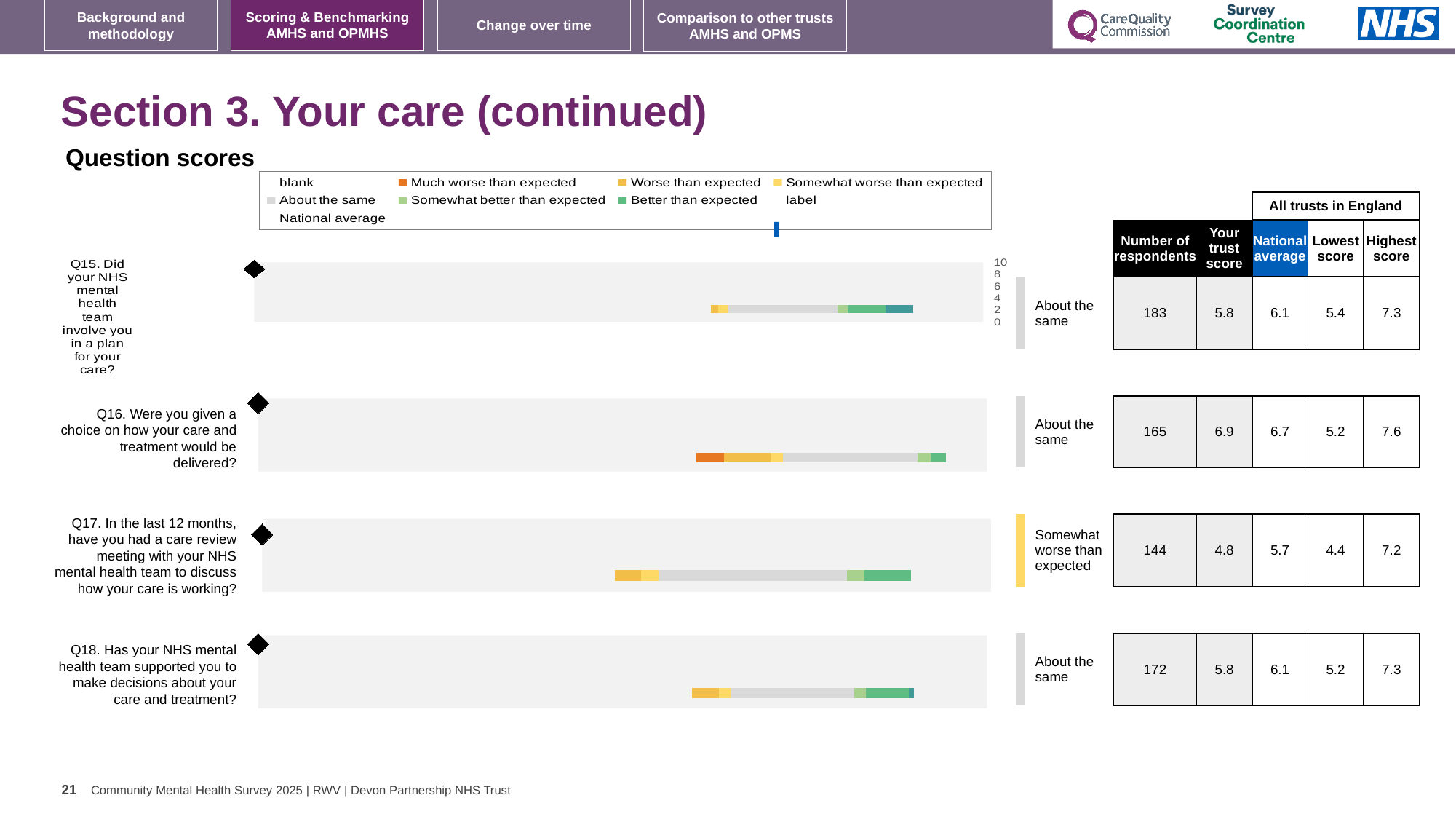
Which benchmark category label is shown next to the bar for Q17? Somewhat worse than expected What colour does the legend use for 'Much worse than expected'? Orange How many questions (Q15 to Q18) have a score bar plotted on the slide? 4 Which question has the highest 'Your trust score'? Q16 For Q16, what is the difference between 'Your trust score' and the national average? 0.2 What is the number of respondents for Q17? 144 Which question has the lowest 'Your trust score'? Q17 What kind of chart is used to show the question scores for Q15 to Q18? bar chart What is the 'Your trust score' value for Q16? 6.9 What is the highest score among all trusts in England for Q18? 7.3 For Q15, which is larger: 'Your trust score' or the national average? National average What is the lowest score among all trusts in England for Q15? 5.4